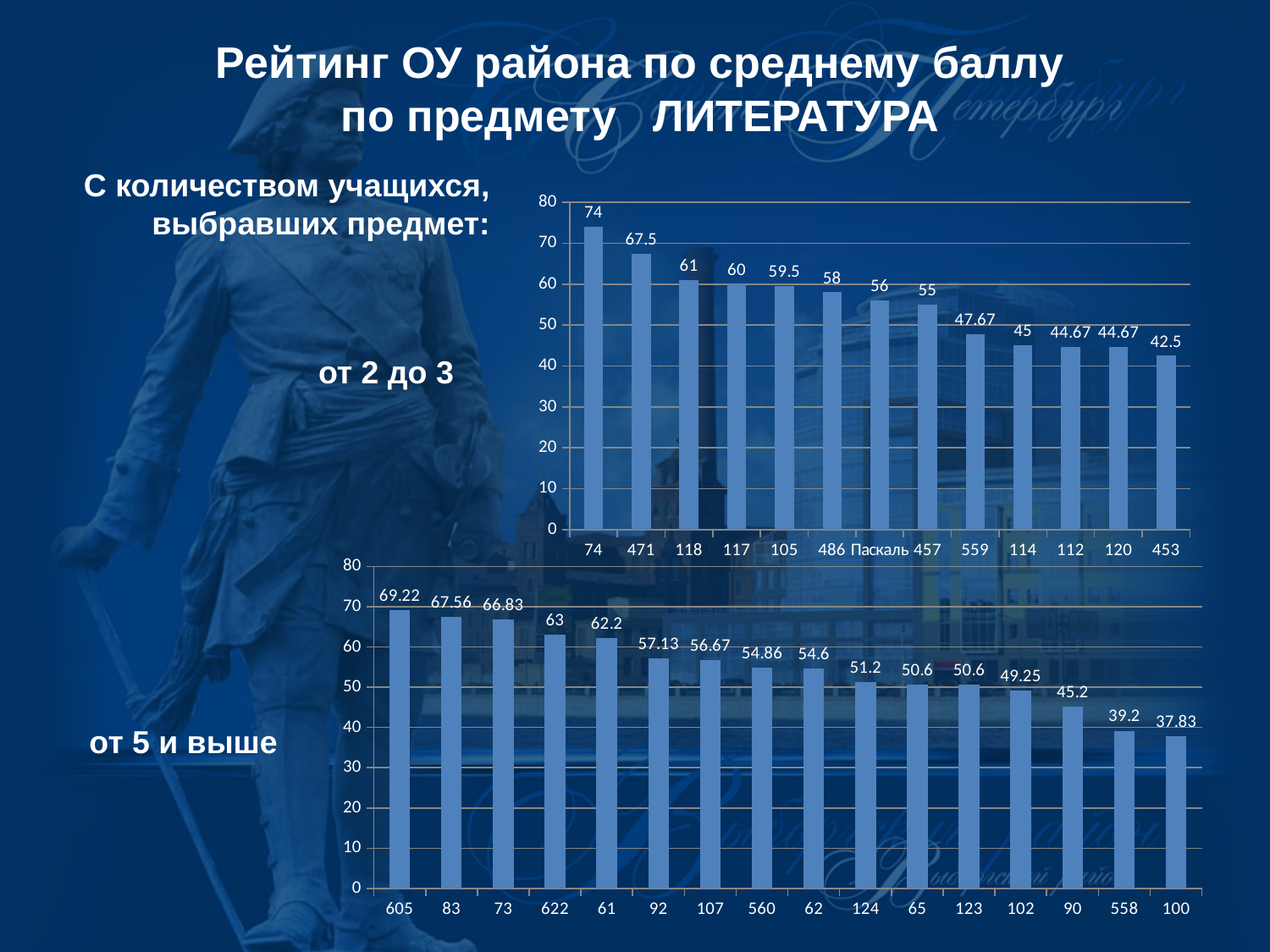
In the bottom chart (от 5 и выше), which is larger, the value for 622 or the value for 61? 622 In the bottom chart (от 5 и выше), which category has the lowest value? 100 In the top chart (от 2 до 3), which category has the lowest value? 453 In the top chart (от 2 до 3), what is the difference between the values for 74 and 453? 31.5 In the bottom chart (от 5 и выше), what is the value for school 605? 69.22 How many categories are shown in the top chart (от 2 до 3)? 13 What type of chart is the bottom chart (от 5 и выше)? bar chart In the bottom chart (от 5 и выше), what is the value for school 558? 39.2 In the top chart (от 2 до 3), which category has the highest value? 74 In the top chart (от 2 до 3), what is the value for Паскаль? 56 In the top chart (от 2 до 3), what is the value for school 471? 67.5 How many categories are shown in the bottom chart (от 5 и выше)? 16